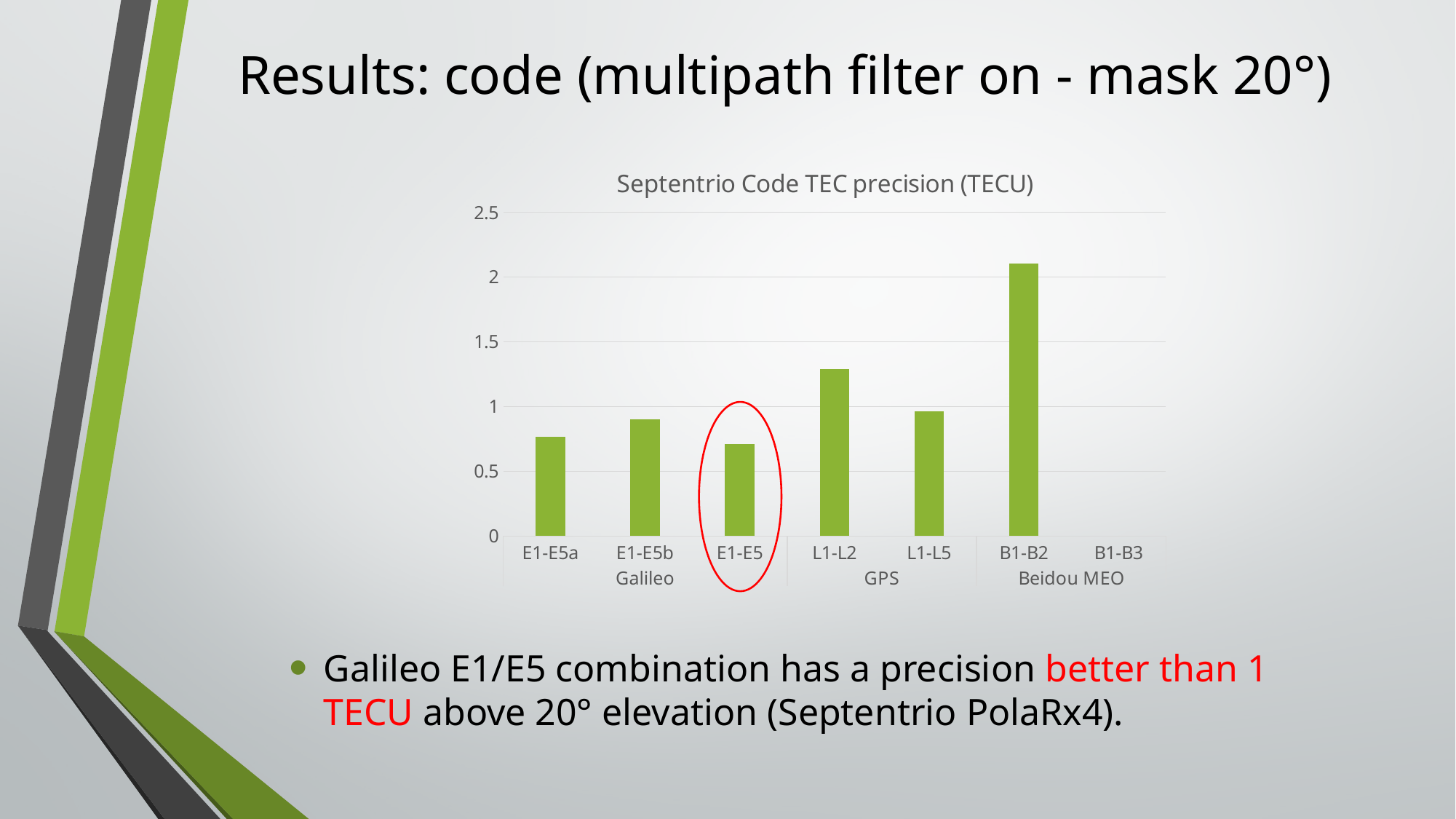
Is the value for E1-E5 greater or less than 1? less What is the title of the chart? Septentrio Code TEC precision (TECU) Which category has the lowest TEC precision value among the plotted bars? E1-E5 What kind of chart is shown on the slide? bar chart Is the value for E1-E5a greater or less than 0.5? greater How many category labels are shown on the x axis? 7 Which category has the highest TEC precision value? B1-B2 Is the value for B1-B2 greater or less than 2? greater Which has a larger value, L1-L2 or E1-E5b? L1-L2 Which has a larger value, B1-B2 or L1-L2? B1-B2 How many constellation groups are labelled below the x axis? 3